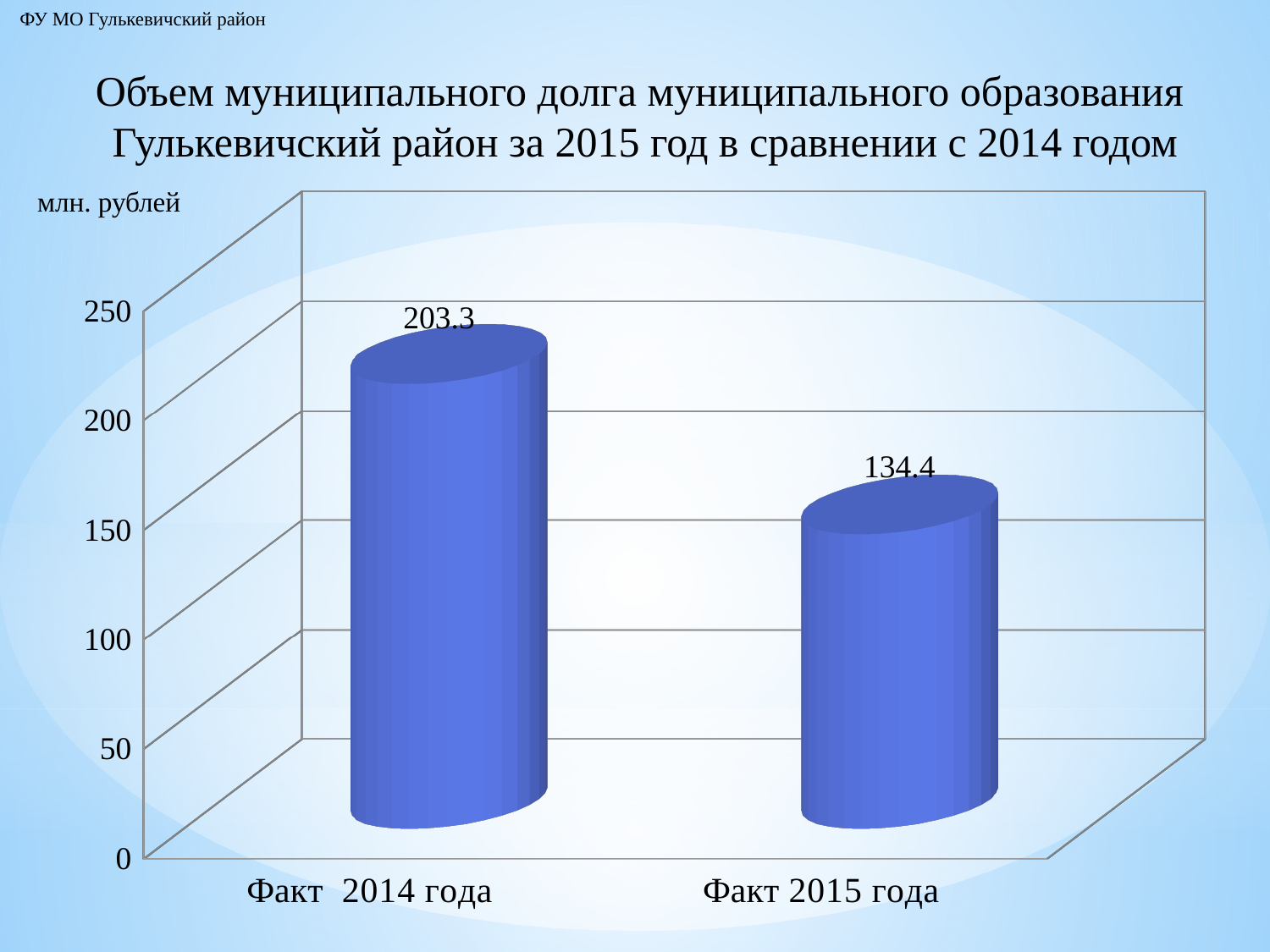
Is the value for Факт 2015 года greater or less than 150? less What is the difference between the values for Факт 2014 года and Факт 2015 года? 68.9 What is the value for Факт 2015 года? 134.4 Which category has the highest value? Факт 2014 года How many categories are shown on the chart? 2 Do the values rise or fall from Факт 2014 года to Факт 2015 года? fall Is the value for Факт 2014 года greater or less than 200? greater What kind of chart is shown on the slide? bar chart Which is larger, the value for Факт 2014 года or Факт 2015 года? Факт 2014 года What unit is shown on the chart's axis label? млн. рублей Which category has the lowest value? Факт 2015 года What is the value for Факт 2014 года? 203.3